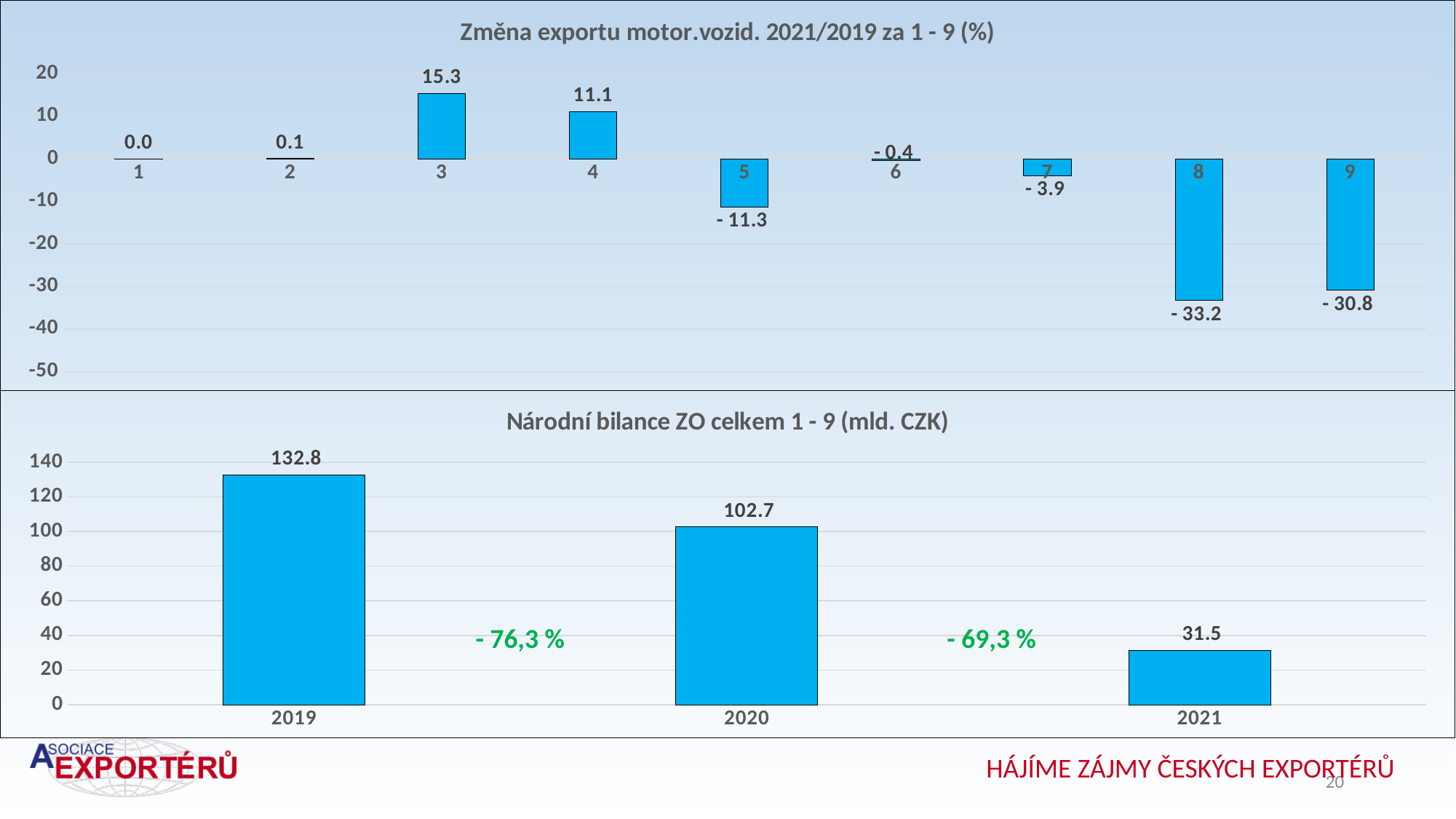
What type of chart is the bottom chart 'Národní bilance ZO celkem 1 - 9 (mld. CZK)'? bar chart In the top chart 'Změna exportu motor.vozid. 2021/2019 za 1 - 9 (%)', which category has the highest value? 3 In the bottom chart 'Národní bilance ZO celkem 1 - 9 (mld. CZK)', do the values rise or fall from 2019 to 2021? fall In the top chart 'Změna exportu motor.vozid. 2021/2019 za 1 - 9 (%)', what is the value for category 3? 15.3 In the top chart 'Změna exportu motor.vozid. 2021/2019 za 1 - 9 (%)', which is larger, the value for category 5 or category 7? 7 In the top chart 'Změna exportu motor.vozid. 2021/2019 za 1 - 9 (%)', which category has the lowest value? 8 In the bottom chart 'Národní bilance ZO celkem 1 - 9 (mld. CZK)', which year has the lowest value? 2021 In the bottom chart 'Národní bilance ZO celkem 1 - 9 (mld. CZK)', what is the value for 2020? 102.7 In the bottom chart 'Národní bilance ZO celkem 1 - 9 (mld. CZK)', what is the difference between the 2019 and 2021 values? 101.3 In the top chart 'Změna exportu motor.vozid. 2021/2019 za 1 - 9 (%)', how many categories are plotted? 9 In the top chart 'Změna exportu motor.vozid. 2021/2019 za 1 - 9 (%)', what is the value for category 8? - 33.2 In the top chart 'Změna exportu motor.vozid. 2021/2019 za 1 - 9 (%)', what is the difference between the values for category 3 and category 4? 4.2